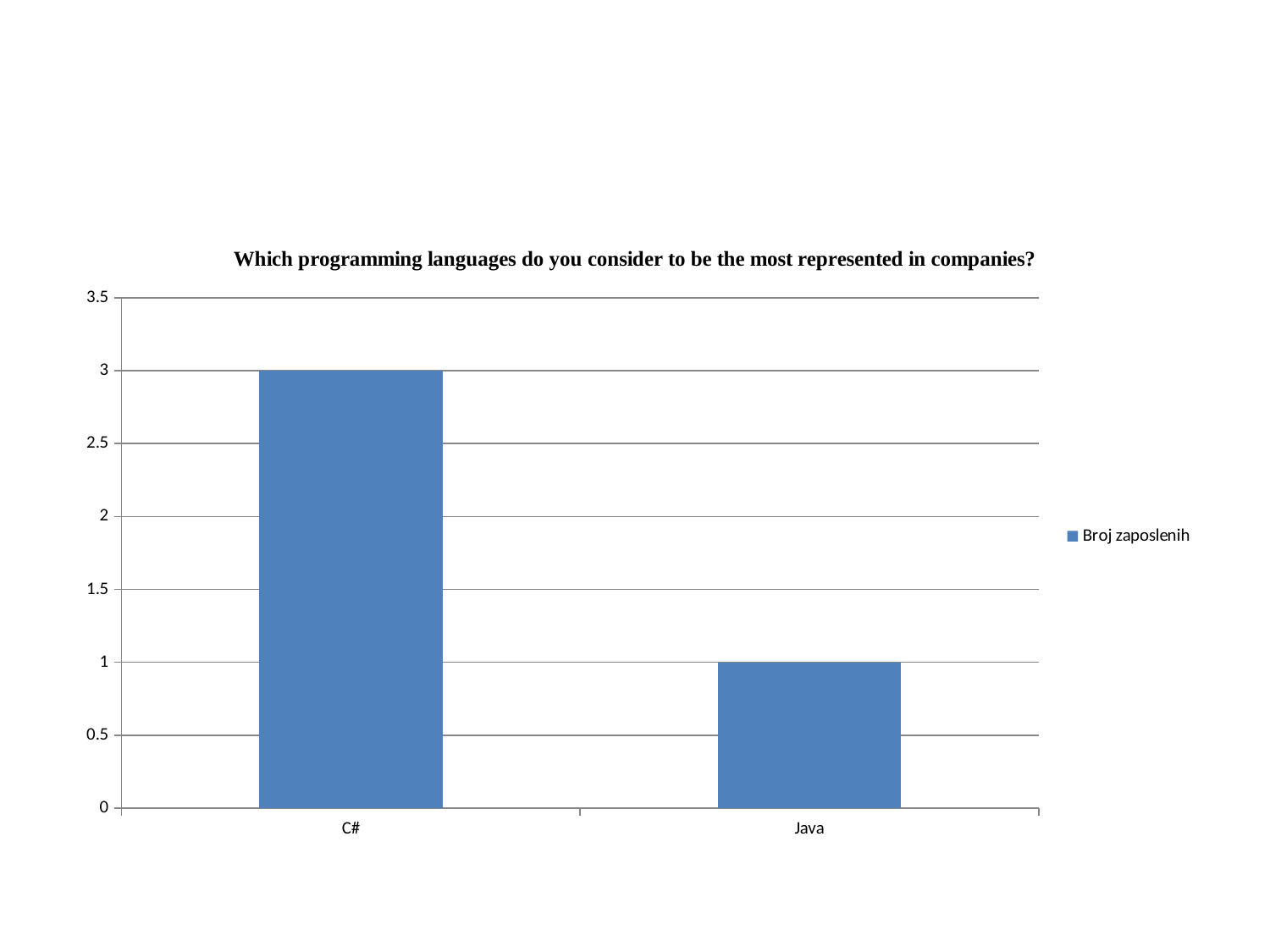
Which is larger, the value for C# or the value for Java? C# What is the difference between the values for C# and Java? 2 What kind of chart is shown on the slide? bar chart What is the legend entry for the series? Broj zaposlenih What is the value for Java? 1 Is the value for C# greater or less than 2? greater What is the value for C#? 3 Is the value for Java greater or less than 2? less Which category has the lowest value? Java How many categories are shown on the x axis? 2 How many series does the legend list? 1 Which category has the highest value? C#